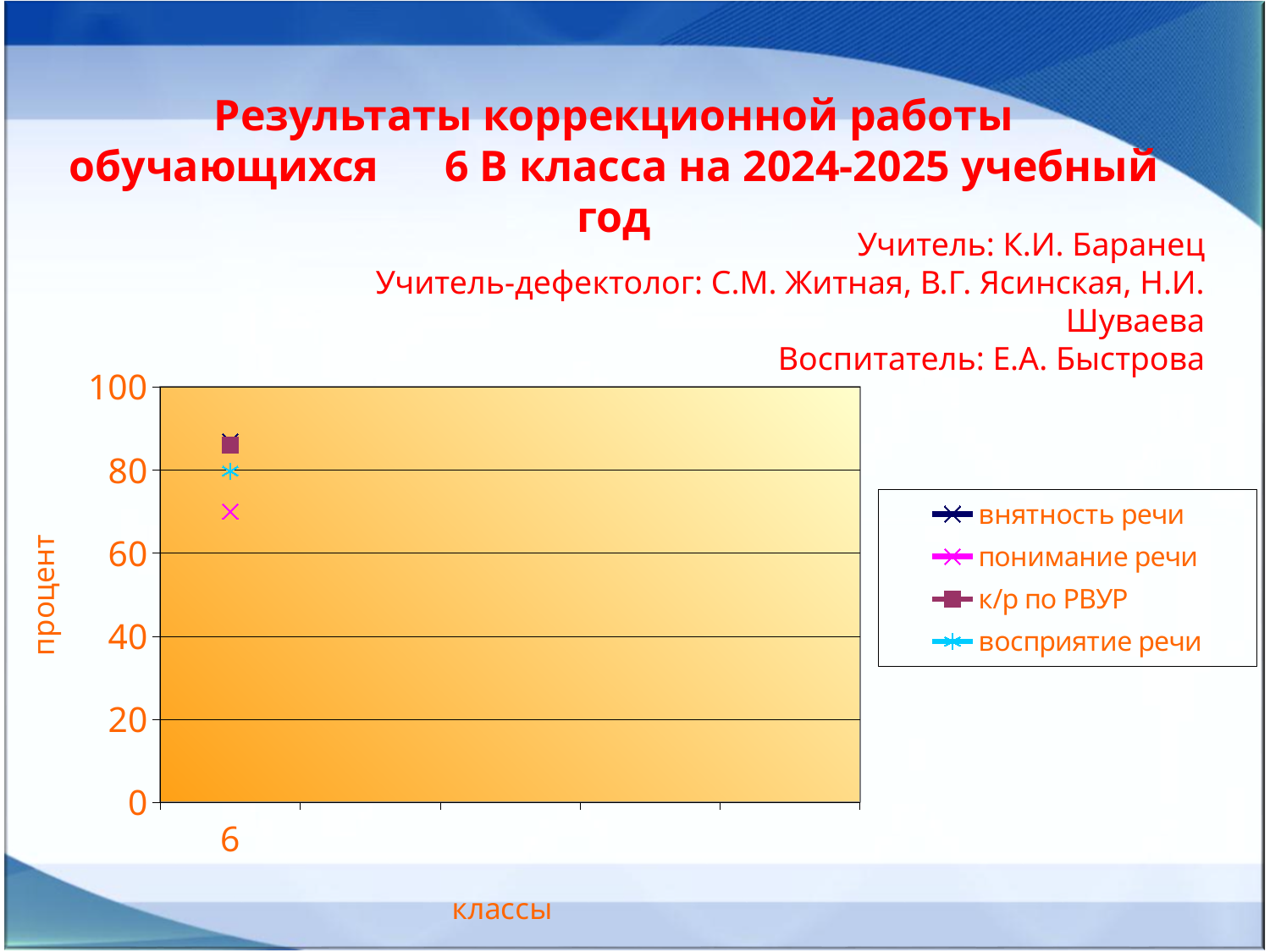
How many series does the chart legend list? 4 What is the title of the vertical axis of the chart? процент Is the value for понимание речи greater or less than 80? less Which series has the lowest value for class 6? понимание речи How many categories are shown on the x axis of the chart? 1 Is the value for к/р по РВУР greater or less than 80? greater Which is larger for class 6: к/р по РВУР or понимание речи? к/р по РВУР Which is larger for class 6: восприятие речи or понимание речи? восприятие речи What kind of chart is shown on the slide? line chart Is the value for понимание речи greater or less than 60? greater What is the title of the horizontal axis of the chart? классы